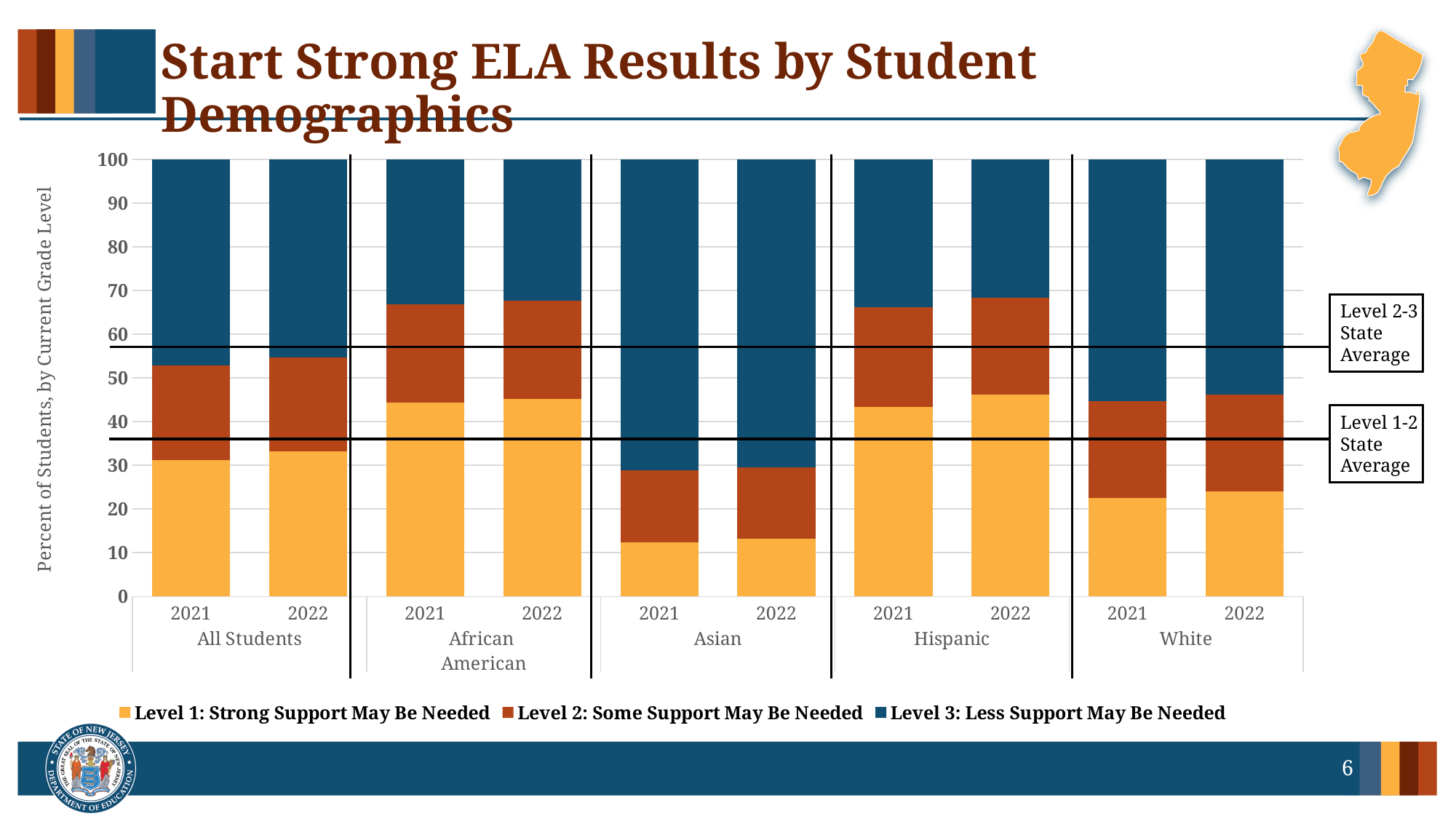
How many bars are plotted in the chart? 10 What is the label of the y axis? Percent of Students, by Current Grade Level How many student demographic groups are shown on the x axis? 5 Is the combined Level 1 and Level 2 share for African American 2021 greater or less than 60? greater Which has a larger Level 1 segment, White 2021 or Asian 2021? White 2021 How many series does the legend list? 3 Which bar has the smallest Level 1: Strong Support May Be Needed segment? Asian 2021 Is the combined Level 1 and Level 2 share for Asian 2022 greater or less than 40? less What kind of chart is shown on the slide? Stacked bar chart From 2021 to 2022, does the Level 1 share for All Students rise or fall? rise Is the Level 1 share for Hispanic 2022 greater or less than 40? greater